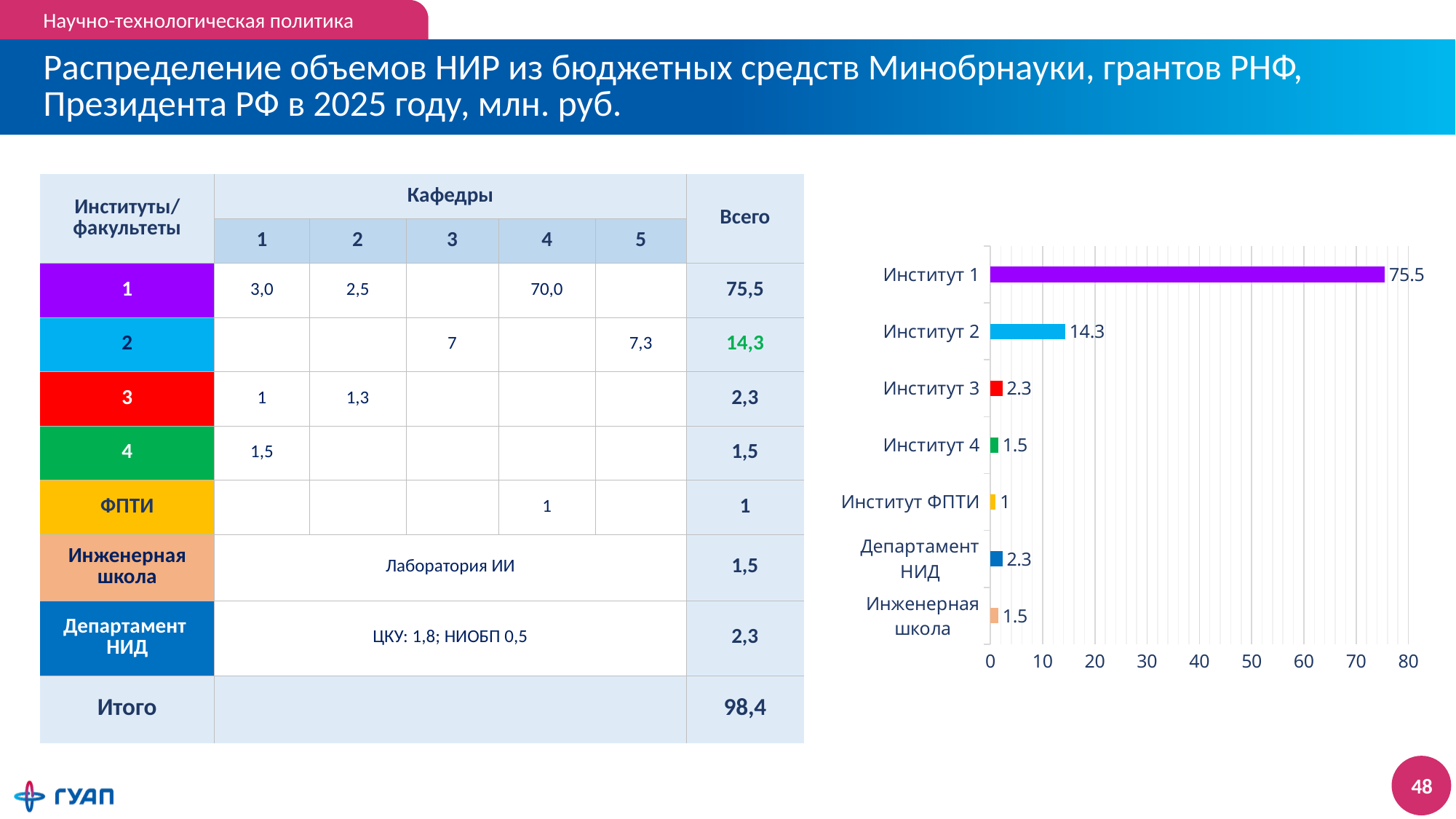
What is the value for Институт 1 in the bar chart? 75.5 What kind of chart is shown on the right of the slide? bar chart What colour is the bar for Институт 3 in the bar chart? red What is the value for Департамент НИД in the bar chart? 2.3 Which category has the highest value in the bar chart? Институт 1 Which is larger in the bar chart, the value for Институт 3 or the value for Институт 4? Институт 3 Which category has the lowest value in the bar chart? Институт ФПТИ What is the value for Институт 2 in the bar chart? 14.3 How many categories are shown in the bar chart? 7 Is the value for Институт 1 in the bar chart greater or less than 70? greater What is the difference between the values for Институт 1 and Институт 2 in the bar chart? 61.2 What is the value for Институт ФПТИ in the bar chart? 1